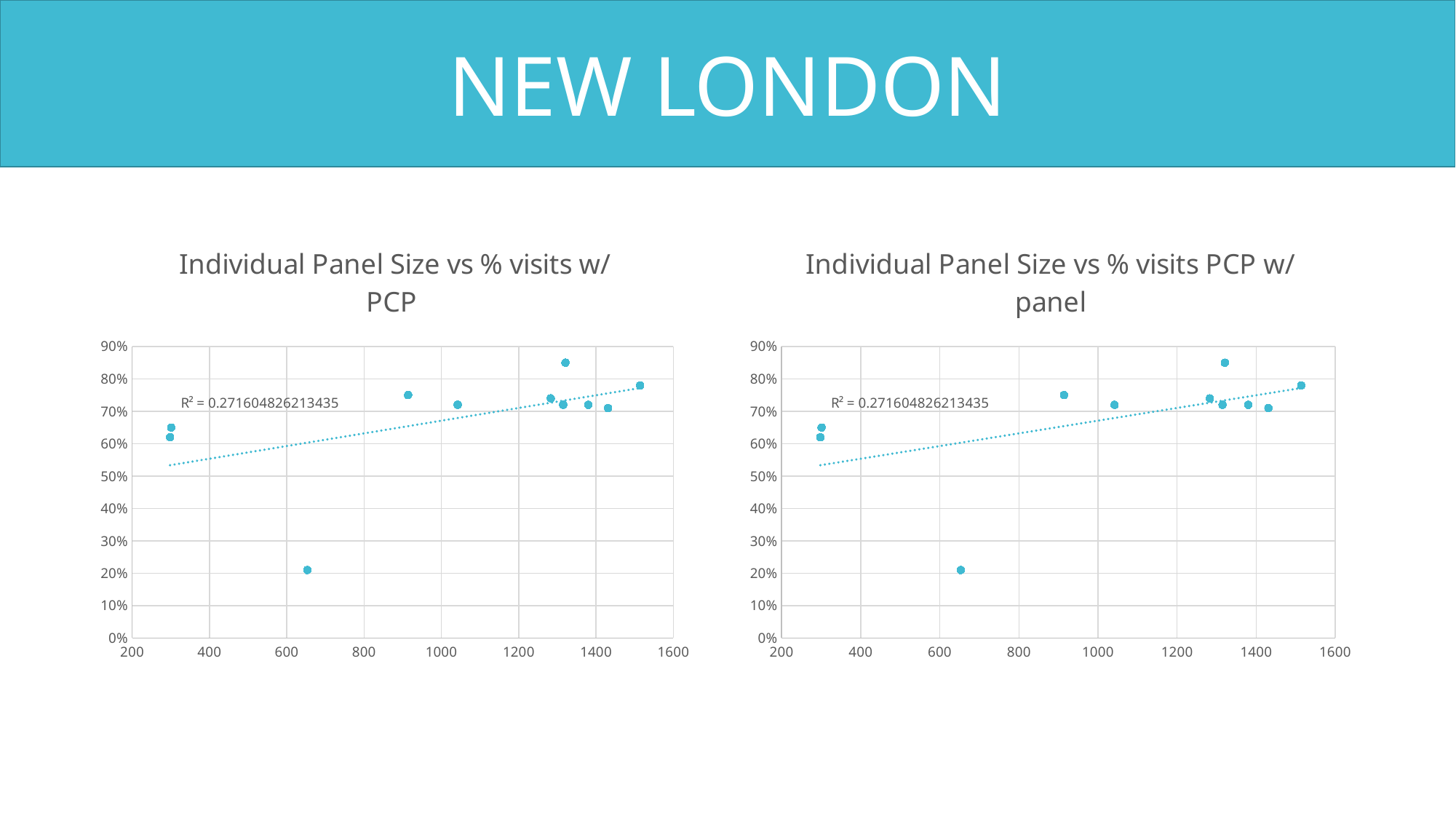
On the left chart, is the lowest point's value greater or less than 30%? less What is the highest value shown on the y axis of the left chart? 90% On the right chart, is the highest point's value greater or less than 80%? greater What is the title of the right chart? Individual Panel Size vs % visits PCP w/ panel On the left chart, what R² value is printed next to the trendline? R² = 0.271604826213435 On the right chart, what R² value is printed next to the trendline? R² = 0.271604826213435 On the left chart, does the dotted trendline rise or fall as panel size increases along the x axis? Rises What kind of chart is the right chart, 'Individual Panel Size vs % visits PCP w/ panel'? Scatter chart On the right chart, does the dotted trendline rise or fall as panel size increases along the x axis? Rises On the left chart, is the value of the point at a panel size of about 650 greater or less than 50%? less What kind of chart is the left chart, 'Individual Panel Size vs % visits w/ PCP'? Scatter chart